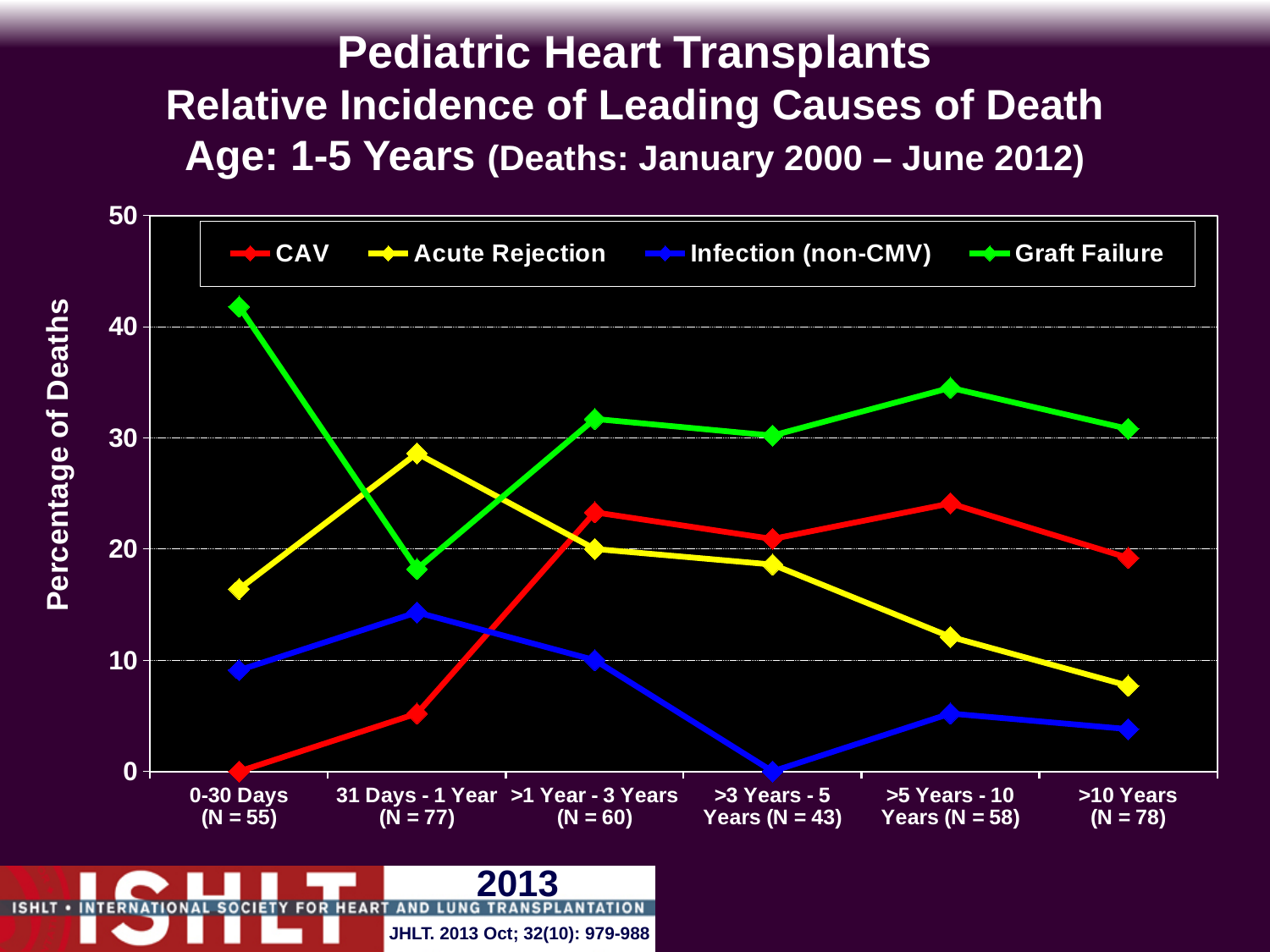
Is the value for Infection (non-CMV) in the >10 Years period greater or less than 10? less Is the value for Graft Failure in the 0-30 Days period greater or less than 40? greater Which cause of death has the lowest percentage in the 0-30 Days period? CAV What is the percentage of deaths for Infection (non-CMV) in the >3 Years - 5 Years period? 0 What is the percentage of deaths for CAV in the 0-30 Days period? 0 Which cause of death has the highest percentage in the 0-30 Days period? Graft Failure How many series does the legend list? 4 Does the Acute Rejection line rise or fall from the 31 Days - 1 Year period to the >10 Years period? fall What kind of chart is shown on the slide? line chart In the 31 Days - 1 Year period, which is larger: Acute Rejection or Graft Failure? Acute Rejection What colour is the Graft Failure line in the legend? green How many time-period categories are shown on the x axis? 6